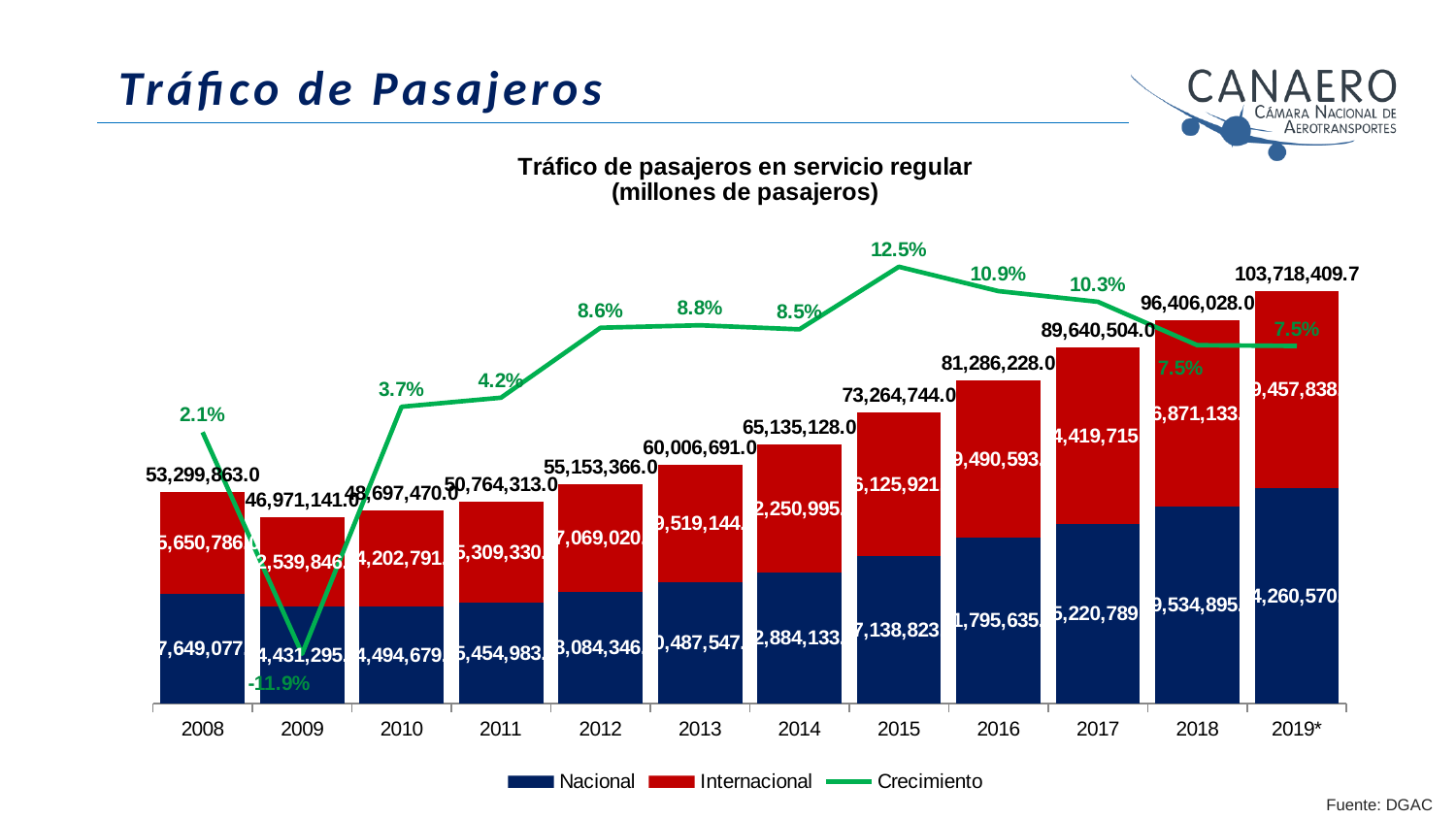
Do the total passenger traffic values rise or fall from 2009 to 2019*? Rise Which year has the lowest total passenger traffic? 2009 What is the difference between the total passenger traffic in 2018 and in 2017? 6,765,524.0 Which year has the highest growth rate on the Crecimiento line? 2015 What is the total passenger traffic value labelled for 2019*? 103,718,409.7 What kind of chart is used to show the Nacional and Internacional passenger traffic? Stacked bar chart What is the source cited for the chart data? DGAC What is the total passenger traffic value shown for 2015? 73,264,744.0 How many years are shown on the x axis? 12 Which year has a higher total passenger traffic, 2010 or 2011? 2011 How many series does the legend list? 3 What growth rate (Crecimiento) is shown for 2009? -11.9%